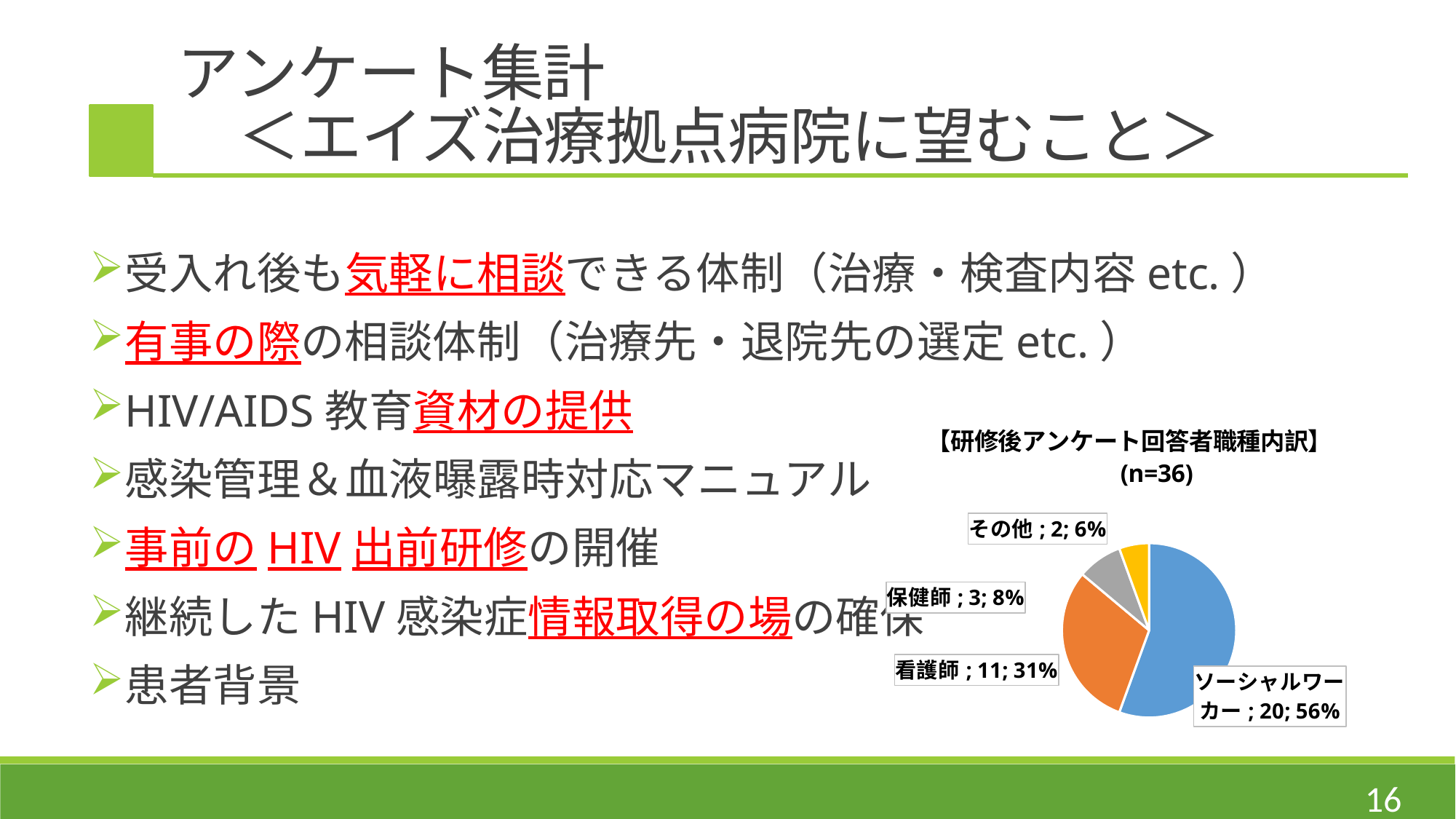
What is the difference in count between ソーシャルワーカー and 看護師? 9 Which category has the smallest slice in the pie chart? その他 What is the count for ソーシャルワーカー in the pie chart? 20 Which category has the largest slice in the pie chart? ソーシャルワーカー How many slices does the pie chart have? 4 What kind of chart is shown on the slide? pie chart Which is larger, the count for 保健師 or the count for その他? 保健師 What share of the pie does 看護師 represent? 31% What is the count for 保健師 in the pie chart? 3 What share of the pie does その他 represent? 6% What colour is the ソーシャルワーカー slice in the pie chart? blue What is the total number of respondents (n) shown in the chart title? 36